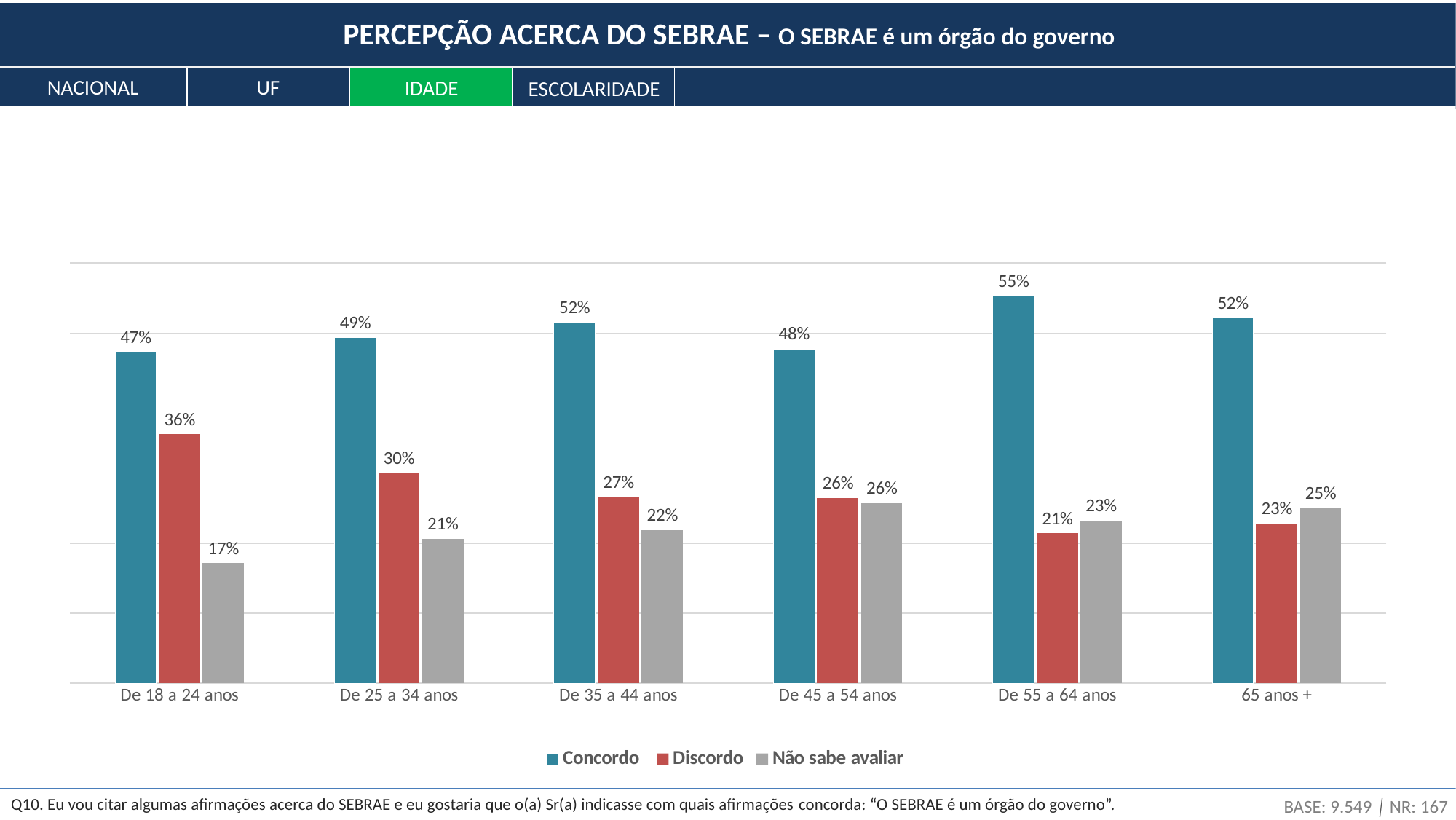
What is the Não sabe avaliar value for 65 anos +? 25% Which age group has the lowest Não sabe avaliar value? De 18 a 24 anos How many series does the legend list? 3 Which age group has the highest Concordo value? De 55 a 64 anos What is the Discordo value for De 25 a 34 anos? 30% Which tab is highlighted in green in the navigation bar? IDADE What is the Concordo value for De 18 a 24 anos? 47% How many age groups are shown on the x axis? 6 What is the difference between the Concordo and Discordo values for De 35 a 44 anos? 25% What kind of chart is shown on the slide? Bar chart Which is larger for De 45 a 54 anos: Discordo or Não sabe avaliar? They are equal (26%) Which is larger for De 55 a 64 anos: Discordo or Não sabe avaliar? Não sabe avaliar